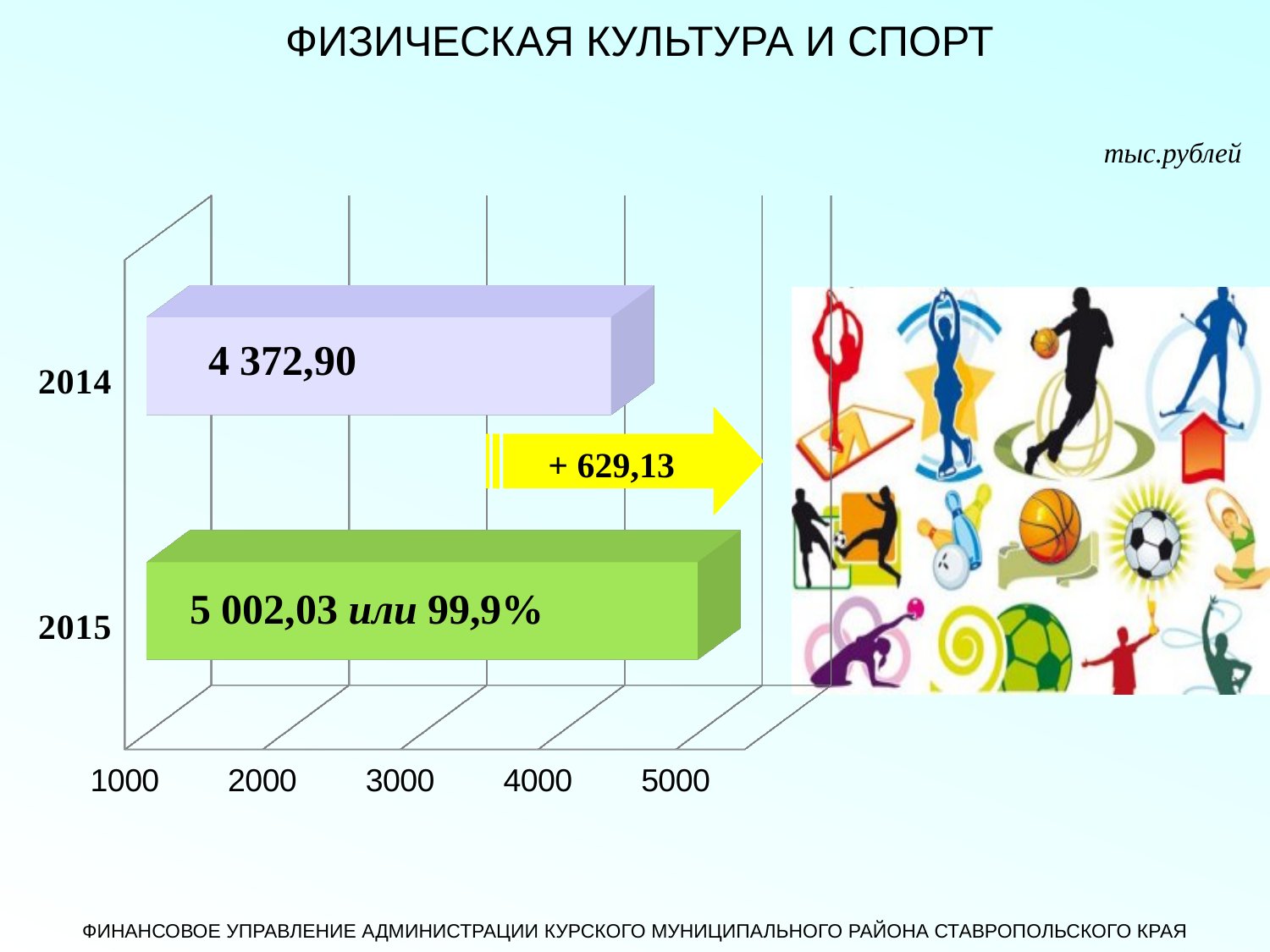
What is the difference between the 2015 and 2014 values? 629,13 How many years are shown in the chart? 2 Which year has the lowest value? 2014 What kind of chart is shown on the slide? bar chart Is the value for 2015 greater or less than 4000? greater What increase is shown on the arrow between the two bars? + 629,13 What percentage is shown next to the 2015 value? 99,9% What is the value for 2015? 5 002,03 What is the value for 2014? 4 372,90 Which year has the higher value, 2014 or 2015? 2015 Is the value for 2014 greater or less than 5000? less What unit is indicated for the chart values? тыс.рублей